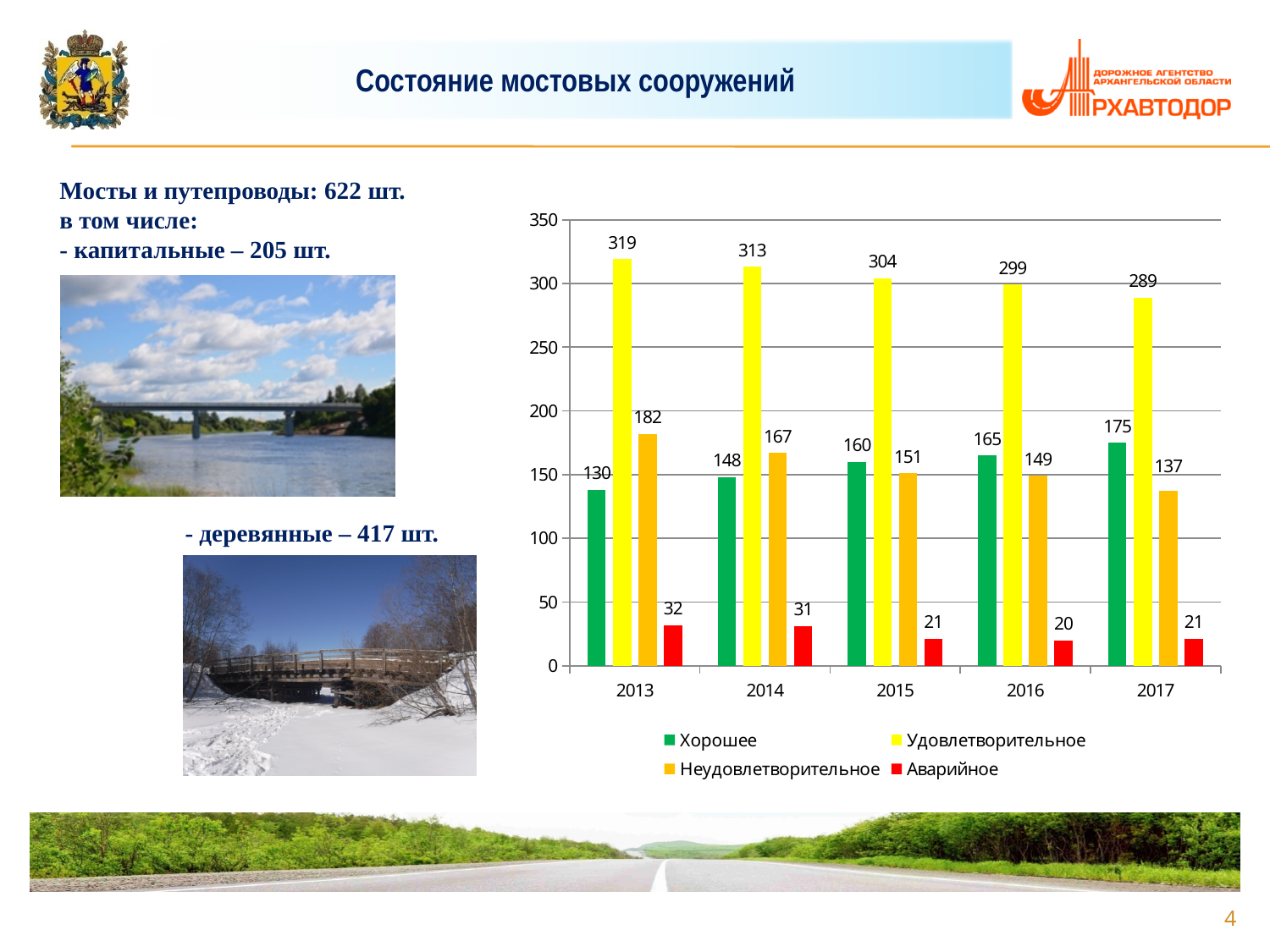
In which year is the value for Хорошее the highest? 2017 In which year is the value for Удовлетворительное the lowest? 2017 What is the difference between the Удовлетворительное values in 2013 and 2017? 30 How many series does the legend list? 4 Does the value for Хорошее rise or fall from 2013 to 2017? Rises How many years are shown on the x axis? 5 What is the value for Хорошее in 2017? 175 What is the value for Удовлетворительное in 2013? 319 What kind of chart is shown on the slide? Bar chart What is the value for Аварийное in 2016? 20 Which is larger: the Хорошее value in 2014 or the Неудовлетворительное value in 2014? Неудовлетворительное in 2014 What is the value for Неудовлетворительное in 2015? 151